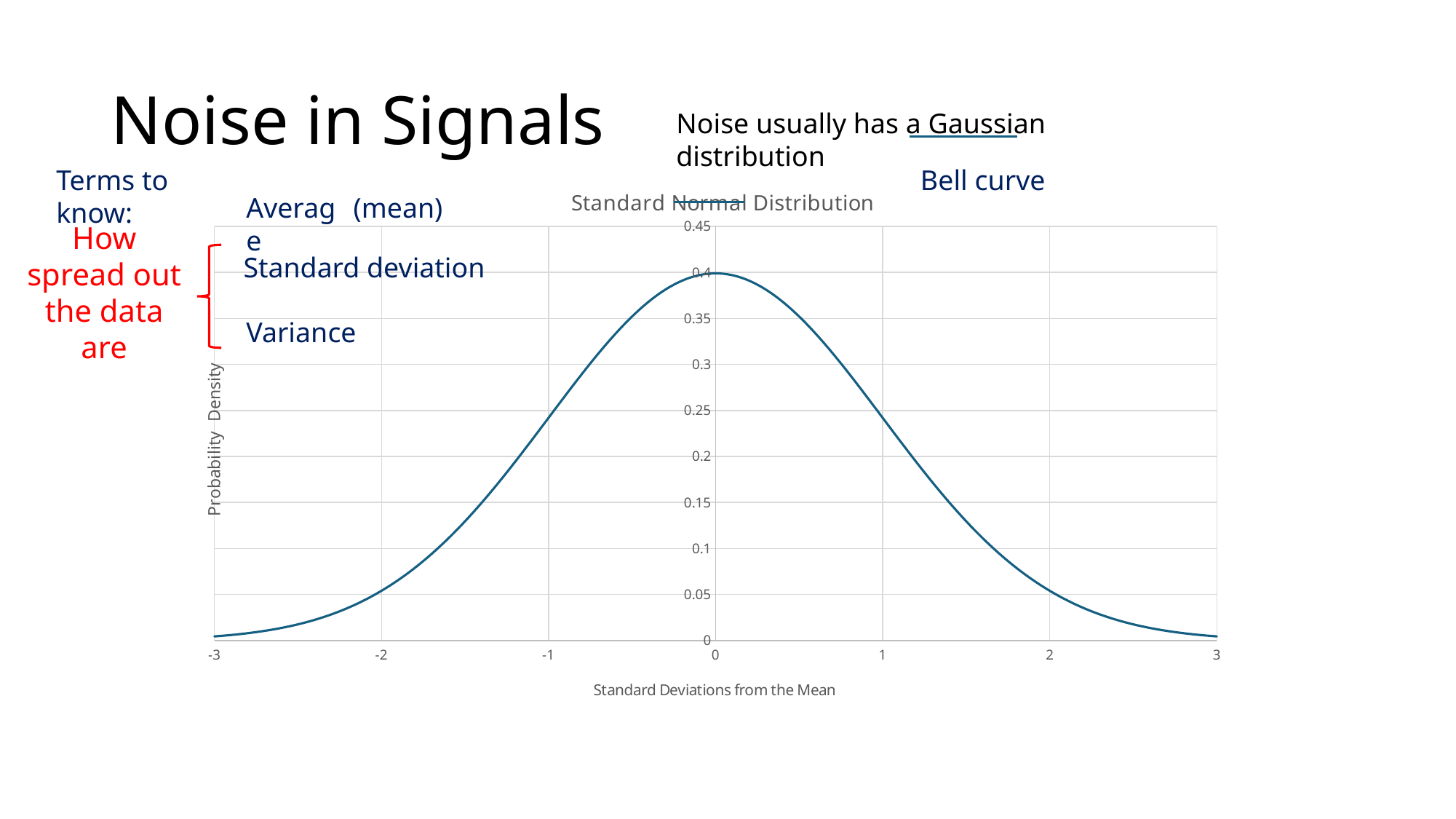
What kind of chart is shown on the slide? line chart Does the curve rise or fall as the x axis goes from 0 to 3? fall Does the curve rise or fall as the x axis goes from -3 to 0? rise Is the probability density at -1 standard deviation from the mean greater or less than 0.2? greater Is the probability density at 1 standard deviation from the mean greater or less than 0.3? less What is the label of the x axis of the chart? Standard Deviations from the Mean How many labelled tick marks are there on the x axis? 7 At which value of standard deviations from the mean does the curve reach its highest point? 0 What is the title of the chart? Standard Normal Distribution Is the probability density at -2 standard deviations from the mean greater or less than 0.1? less Which is larger: the probability density at -1 or at 2 standard deviations from the mean? -1